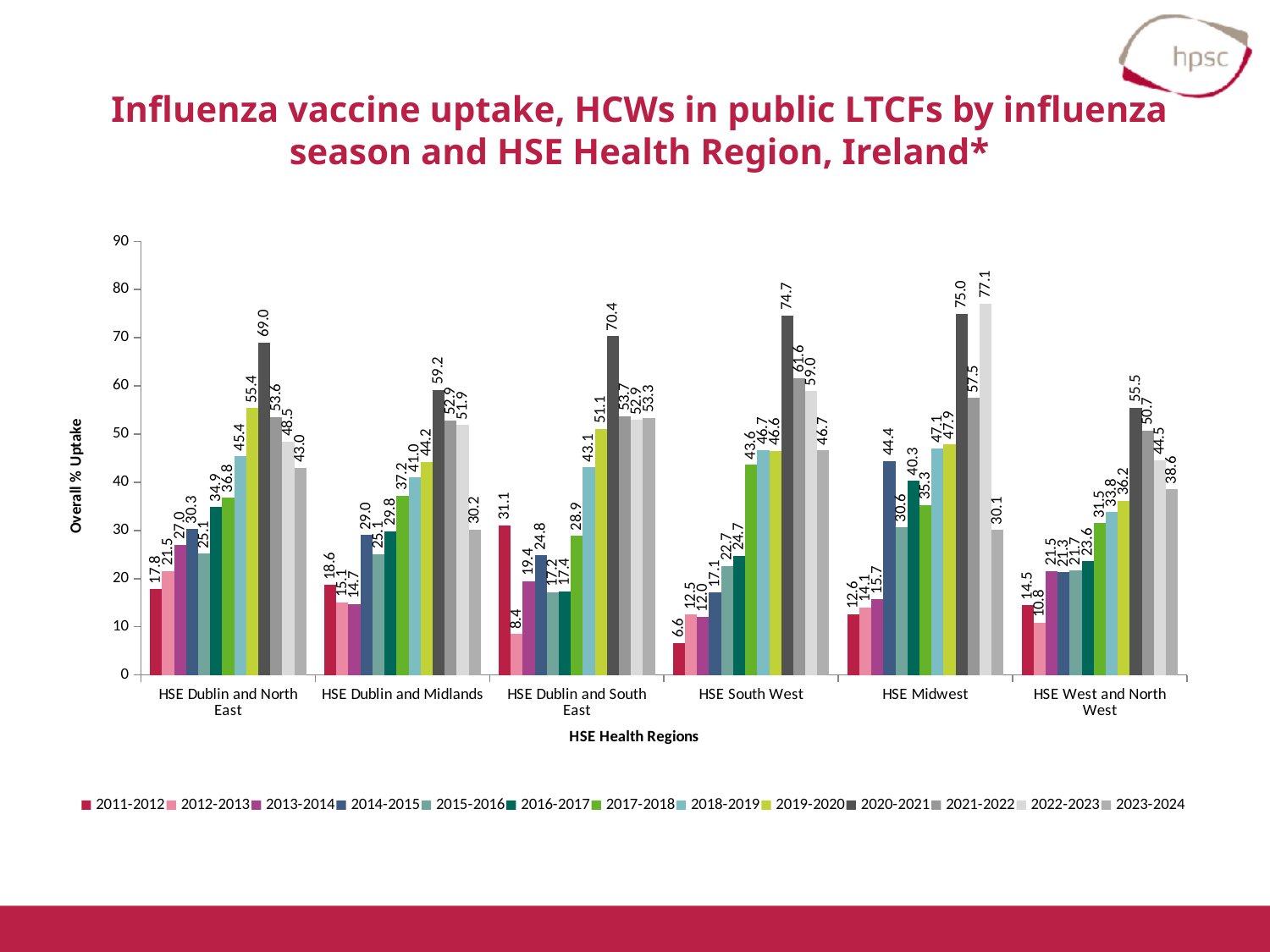
Is the 2020-2021 value for HSE West and North West greater or less than 50? greater How many influenza seasons does the legend list? 13 Which region has the lowest value in the 2011-2012 season? HSE South West How many HSE Health Regions are shown on the x axis? 6 Which region and season has the highest uptake value on the chart? HSE Midwest, 2022-2023 What is the label of the y axis? Overall % Uptake What is the value for HSE West and North West in the 2011-2012 season? 14.5 In the 2022-2023 season, which has the higher uptake: HSE Midwest or HSE South West? HSE Midwest What is the value for HSE Dublin and Midlands in the 2023-2024 season? 30.2 What type of chart is shown on the slide? Bar chart What is the difference between the 2020-2021 and 2023-2024 values for HSE Dublin and North East? 26.0 What is the influenza vaccine uptake for HSE South West in the 2020-2021 season? 74.7